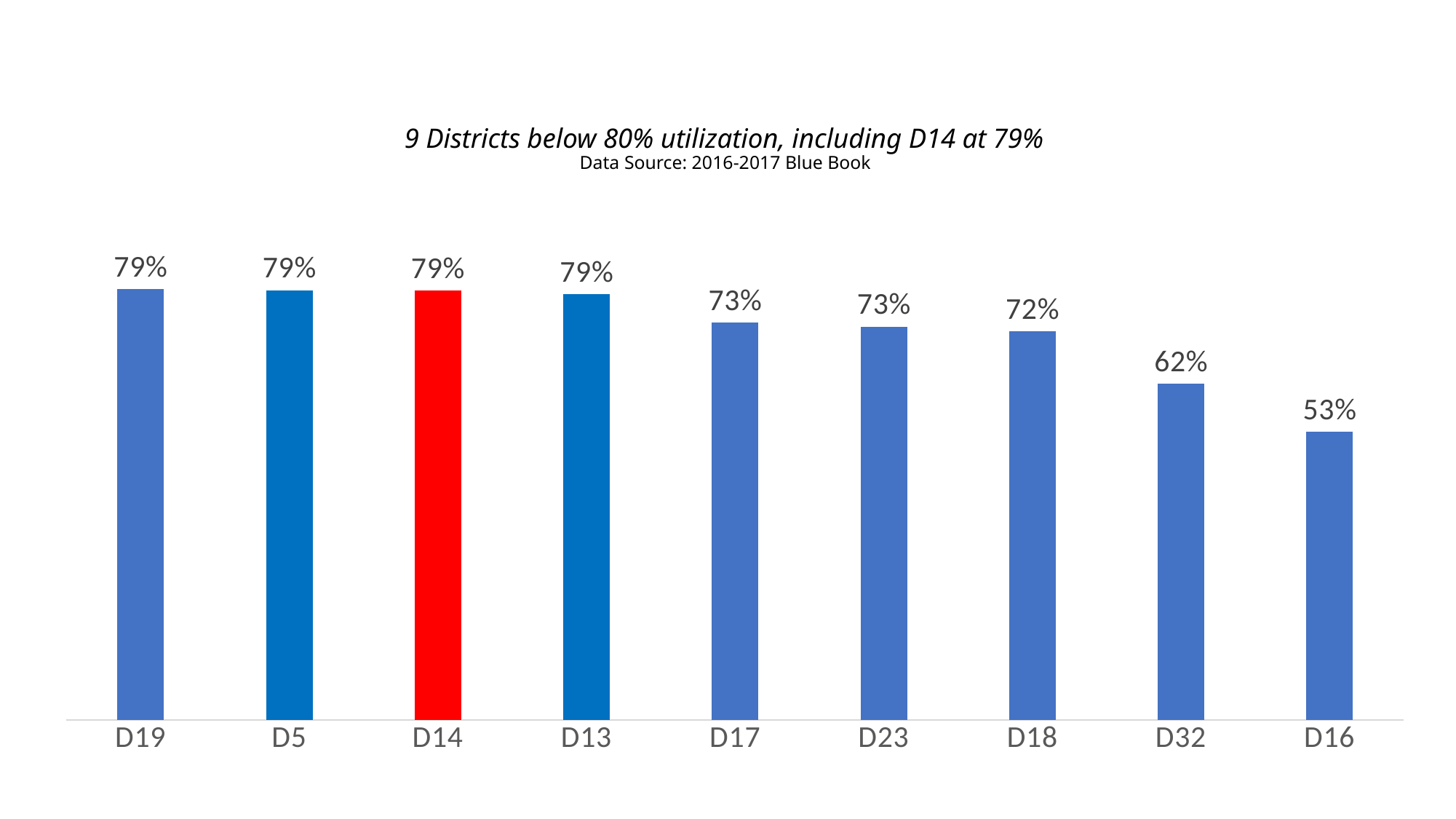
Which district's bar is coloured red? D14 What is the utilization value for D32? 62% Which district has the lowest utilization? D16 What is the difference between the utilization of D17 and D32? 11% Which has a higher utilization, D23 or D32? D23 How many districts are shown in the chart? 9 What is the difference between the utilization of D19 and D16? 26% Do the values rise or fall from left to right along the x axis? Fall What is the utilization value for D18? 72% What kind of chart is shown on the slide? Bar chart What is the utilization value for D14? 79% What is the utilization value for D16? 53%